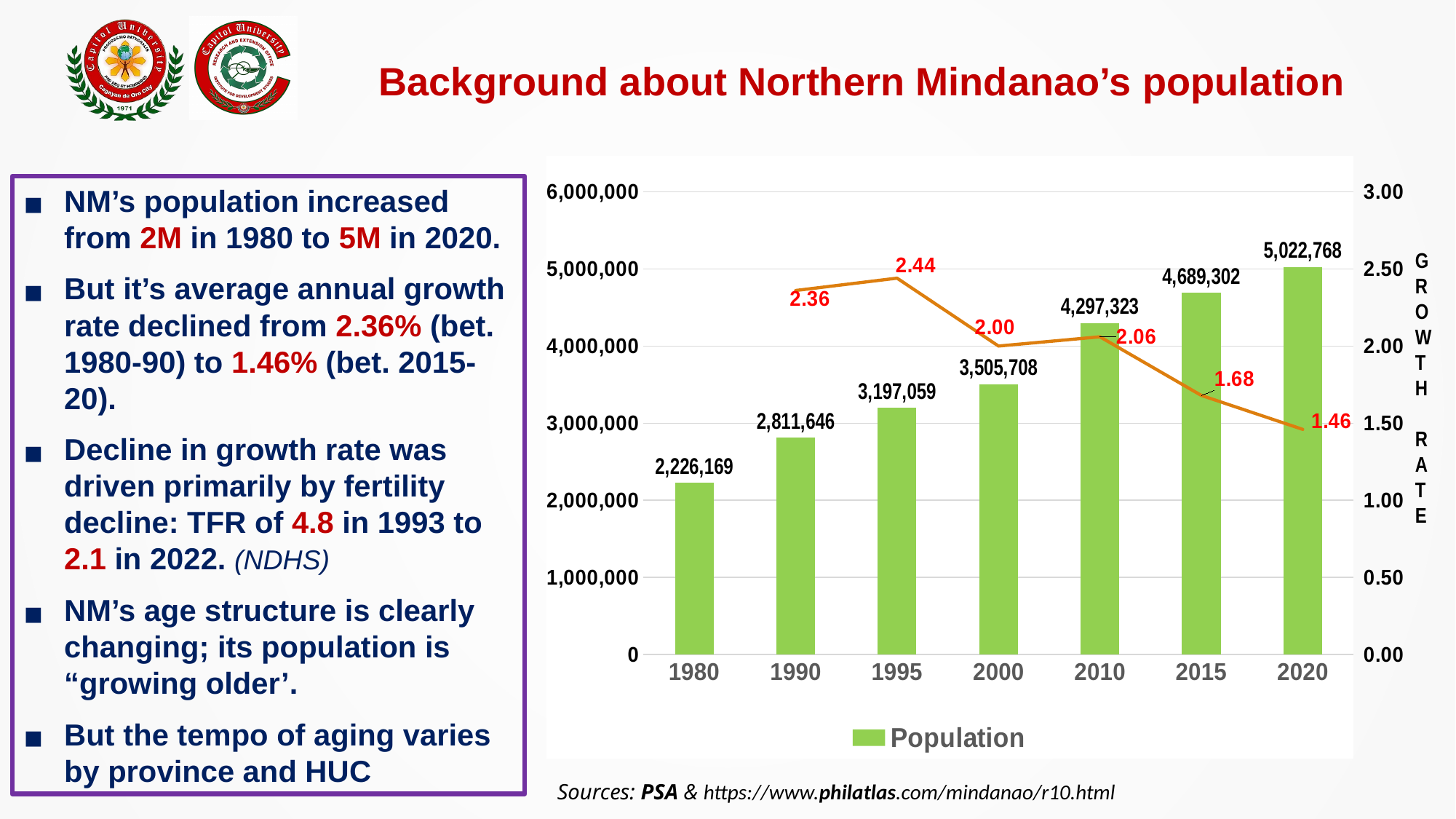
How many years are shown on the x axis of the chart? 7 What is the difference between the population in 2020 and the population in 2015? 333,466 What growth rate value is labelled on the line for 1995? 2.44 Is the population bar for 2000 greater or less than 4,000,000? less What series name is listed in the chart legend? Population Which year has the highest population bar? 2020 What population value is shown for 2010? 4,297,323 Which year has the lowest population bar? 1980 What was the population of Northern Mindanao in 1980 according to the chart? 2,226,169 Does the growth rate line rise or fall between 1995 and 2020? fall Which is larger, the growth rate labelled for 2000 or for 2010? 2010 What growth rate value is labelled on the line for 2020? 1.46